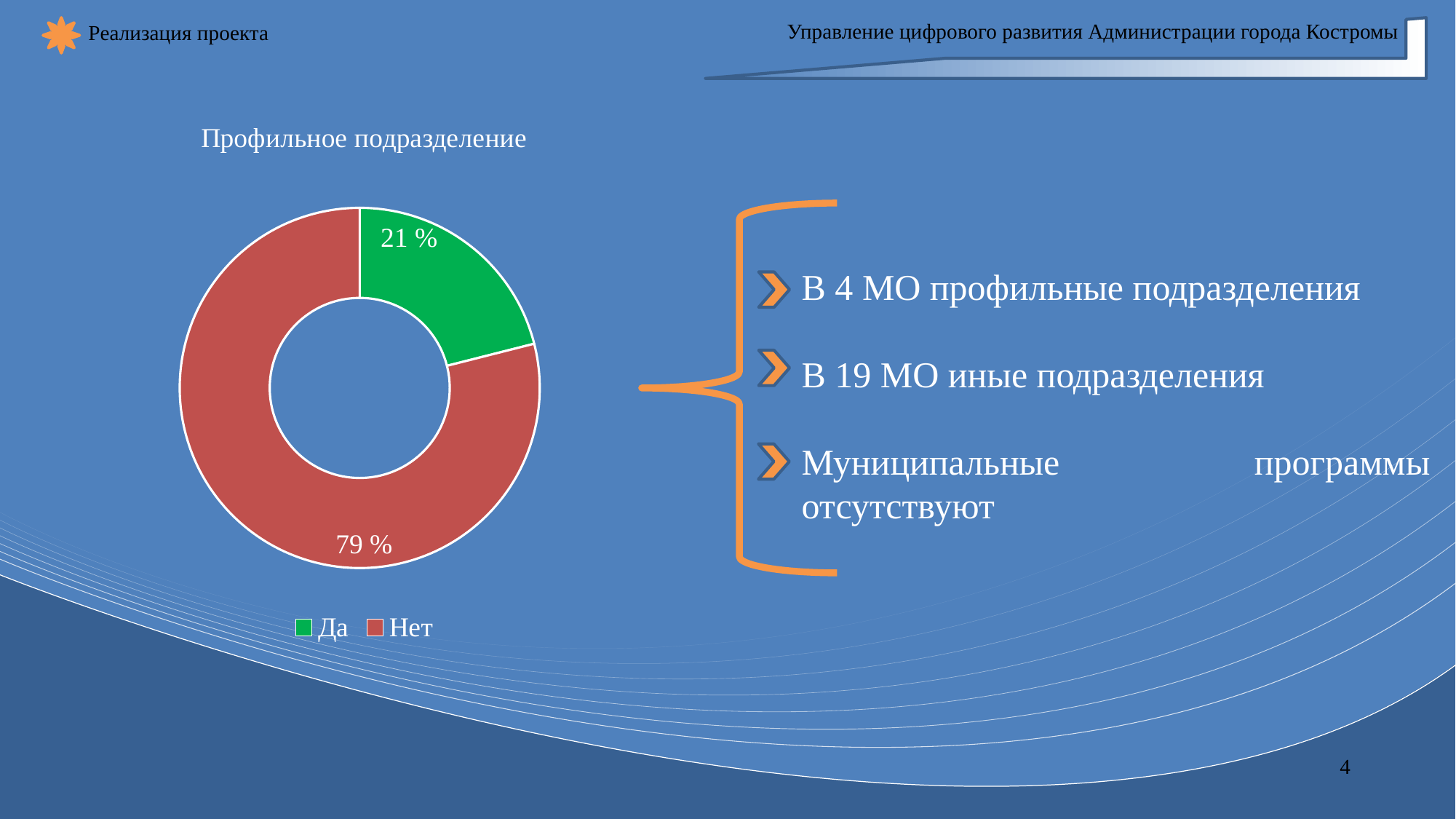
What share of the chart does the "Да" slice represent? 21 % How many categories does the "Профильное подразделение" chart show? 2 What is the difference in percentage points between the "Нет" and "Да" slices? 58 What is the value shown for the "Да" slice in the "Профильное подразделение" chart? 21 % What kind of chart is shown on the slide? Doughnut (pie) chart Which category has the largest slice in the "Профильное подразделение" chart? Нет Which category has the smallest slice in the "Профильное подразделение" chart? Да What is the value shown for the "Нет" slice in the "Профильное подразделение" chart? 79 % What colour is the "Нет" slice in the chart? Red What is the title of the chart on the slide? Профильное подразделение Which slice is larger, "Да" or "Нет"? Нет How many entries does the legend of the chart list? 2